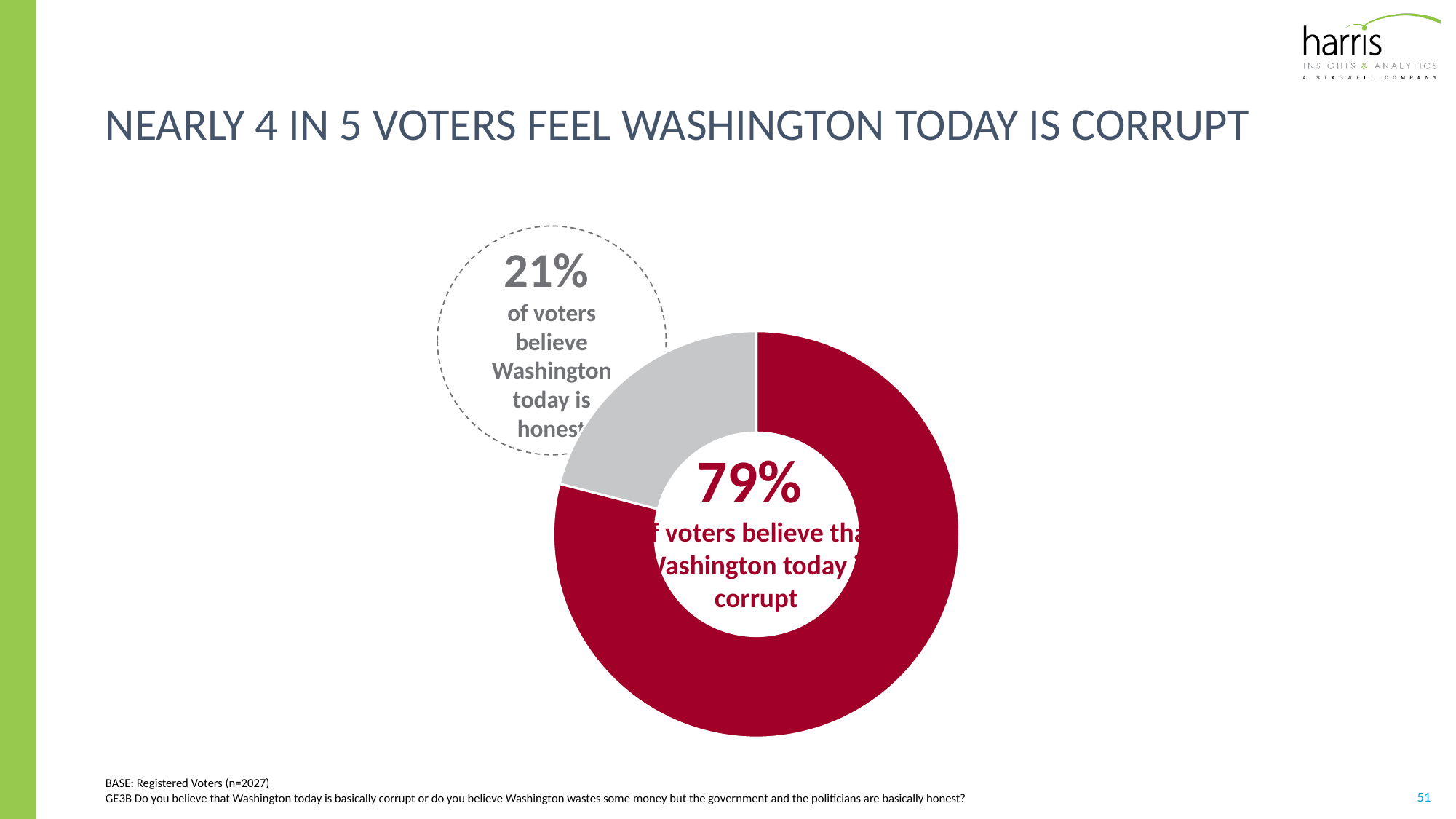
What colour is the segment representing voters who believe Washington is corrupt? Red Which view is held by the larger share of voters: that Washington is corrupt or that it is honest? Corrupt What percentage of voters believe that Washington today is corrupt? 79% Which view is held by the smaller share of voters: that Washington is corrupt or that it is honest? Honest What do the two segments of the chart add up to? 100% Is the share of voters who believe Washington is corrupt larger or smaller than the share who believe it is honest? Larger What is the difference in percentage points between the share of voters who believe Washington is corrupt and the share who believe it is honest? 58 How many segments does the chart have? 2 Is the share of voters who believe Washington is honest greater or less than 25%? less What percentage of voters believe Washington today is honest? 21% What colour is the segment representing voters who believe Washington is honest? Grey What kind of chart is shown on the slide? Donut (pie) chart